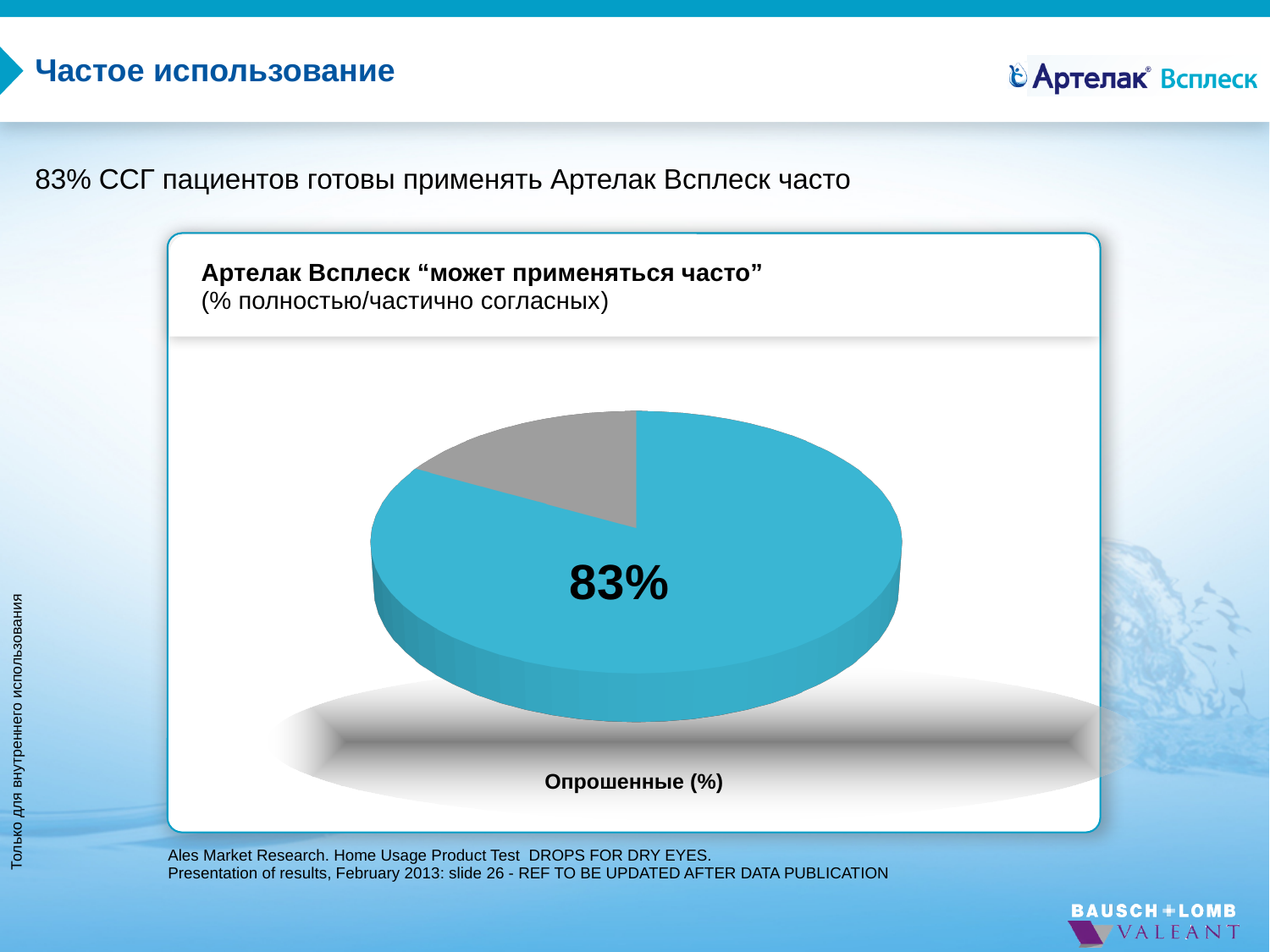
What percentage is printed on the large blue slice of the pie chart? 83% Is the share of the grey slice greater or less than 50%? less How many slices does the pie chart have? 2 Is the share of the blue slice greater or less than 50%? greater What kind of chart is shown on the slide? pie chart Which slice of the pie chart is larger, the blue one or the grey one? the blue one What is the title of the chart? Артелак Всплеск “может применяться часто” (% полностью/частично согласных) What label appears below the pie chart? Опрошенные (%)